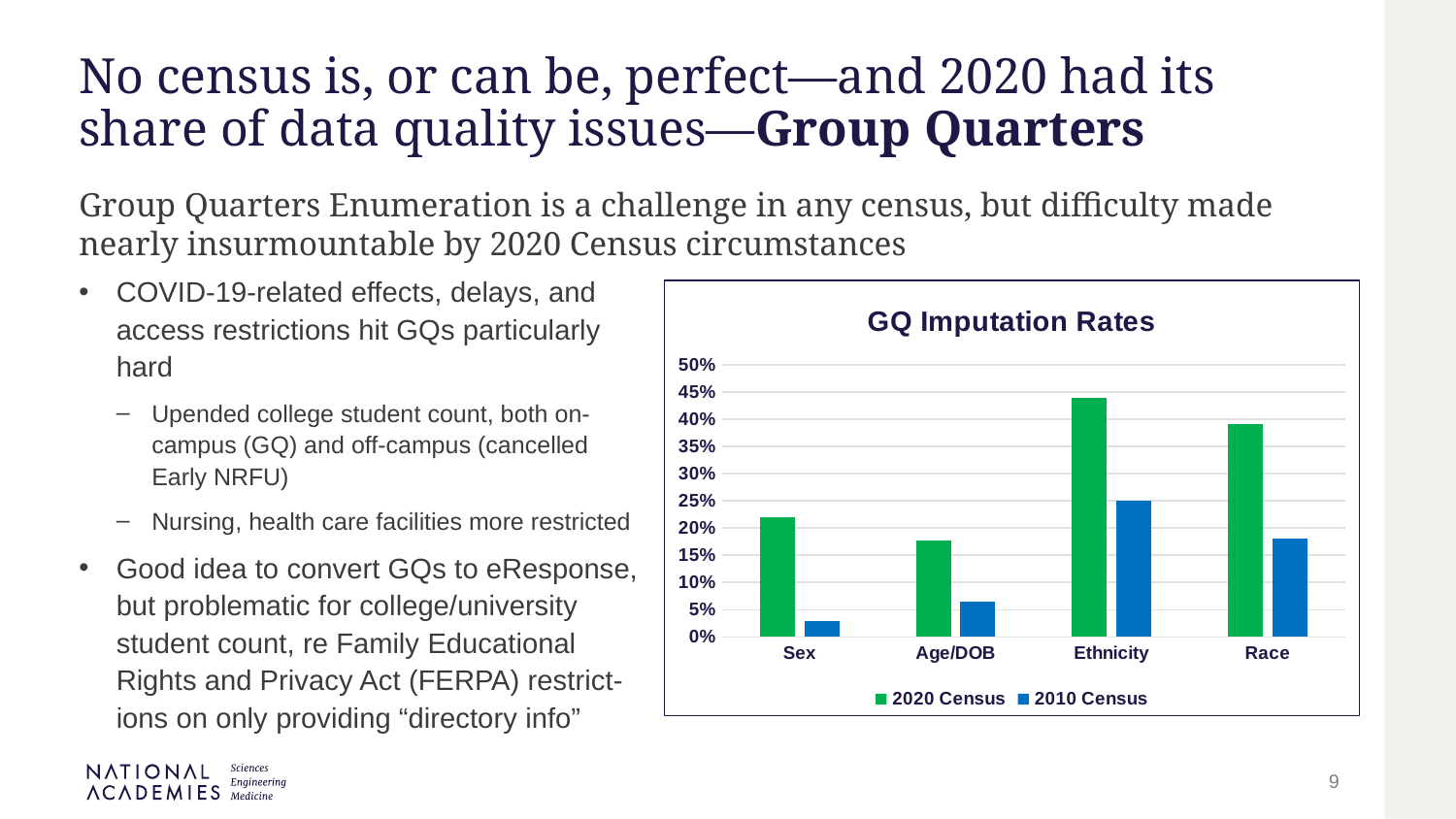
For Race, which is larger: the 2020 Census value or the 2010 Census value? 2020 Census Is the 2020 Census value for Race greater or less than 35%? greater Which category has the lowest 2020 Census imputation rate? Age/DOB Is the 2020 Census value for Ethnicity greater or less than 40%? greater Which series is shown in green in the chart? 2020 Census Which category has the highest 2020 Census imputation rate? Ethnicity What kind of chart is shown on the slide? bar chart How many series does the chart's legend list? 2 Which category has the lowest 2010 Census imputation rate? Sex Is the 2010 Census value for Sex greater or less than 5%? less What is the title of the chart? GQ Imputation Rates How many categories are shown on the x axis of the chart? 4